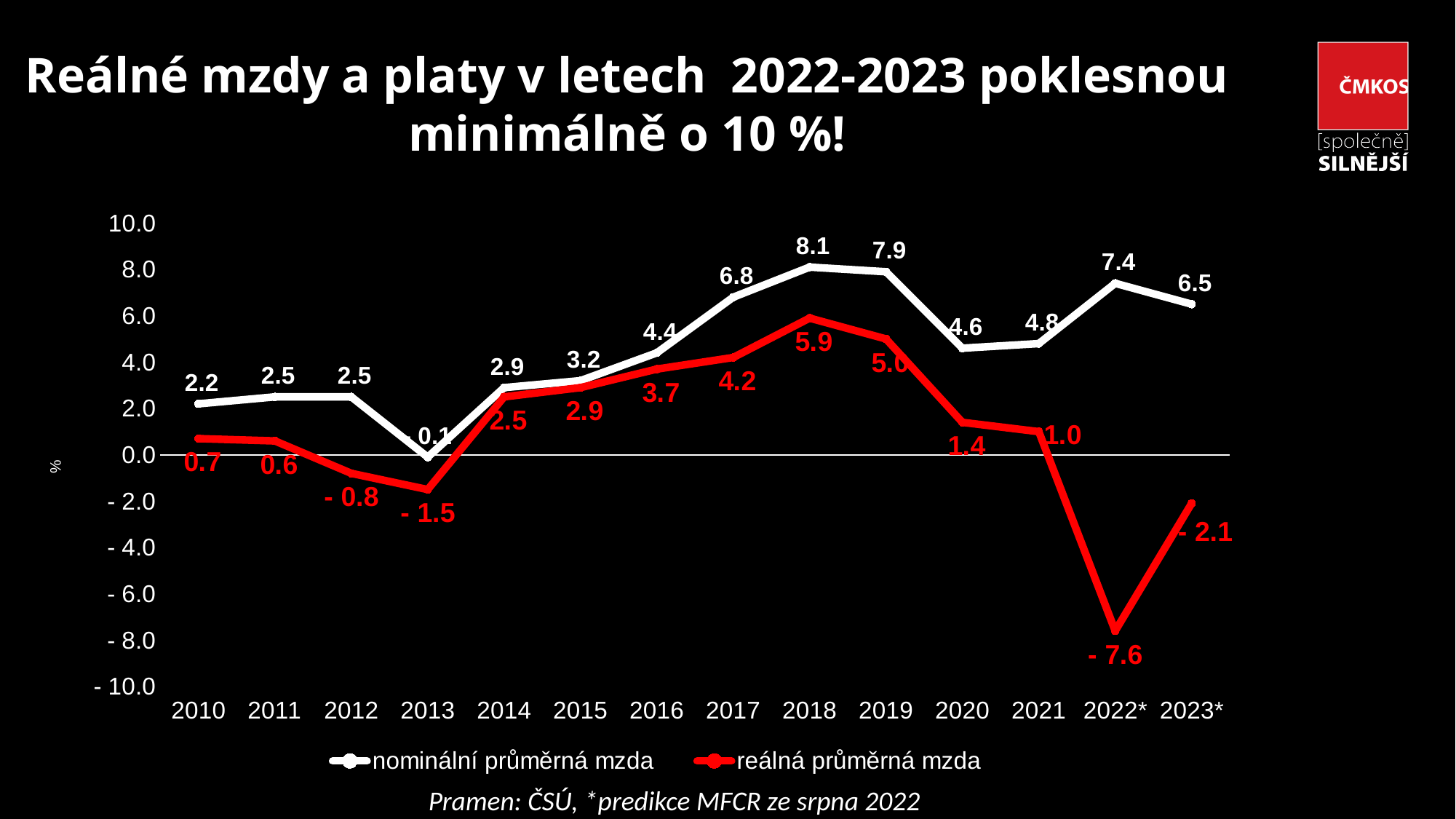
In which year is reálná průměrná mzda lowest? 2022* What colour is the line for reálná průměrná mzda? red What type of chart is shown on the slide? line chart In which year is nominální průměrná mzda highest? 2018 Which is larger in 2021: nominální průměrná mzda or reálná průměrná mzda? nominální průměrná mzda What is the value for nominální průměrná mzda in 2018? 8.1 What is the value for reálná průměrná mzda in 2013? - 1.5 Does reálná průměrná mzda rise or fall from 2018 to 2022*? fall How many series does the legend list? 2 What is the value for reálná průměrná mzda in 2022*? - 7.6 How many years are shown on the x axis? 14 What is the difference between nominální průměrná mzda and reálná průměrná mzda in 2023*? 8.6